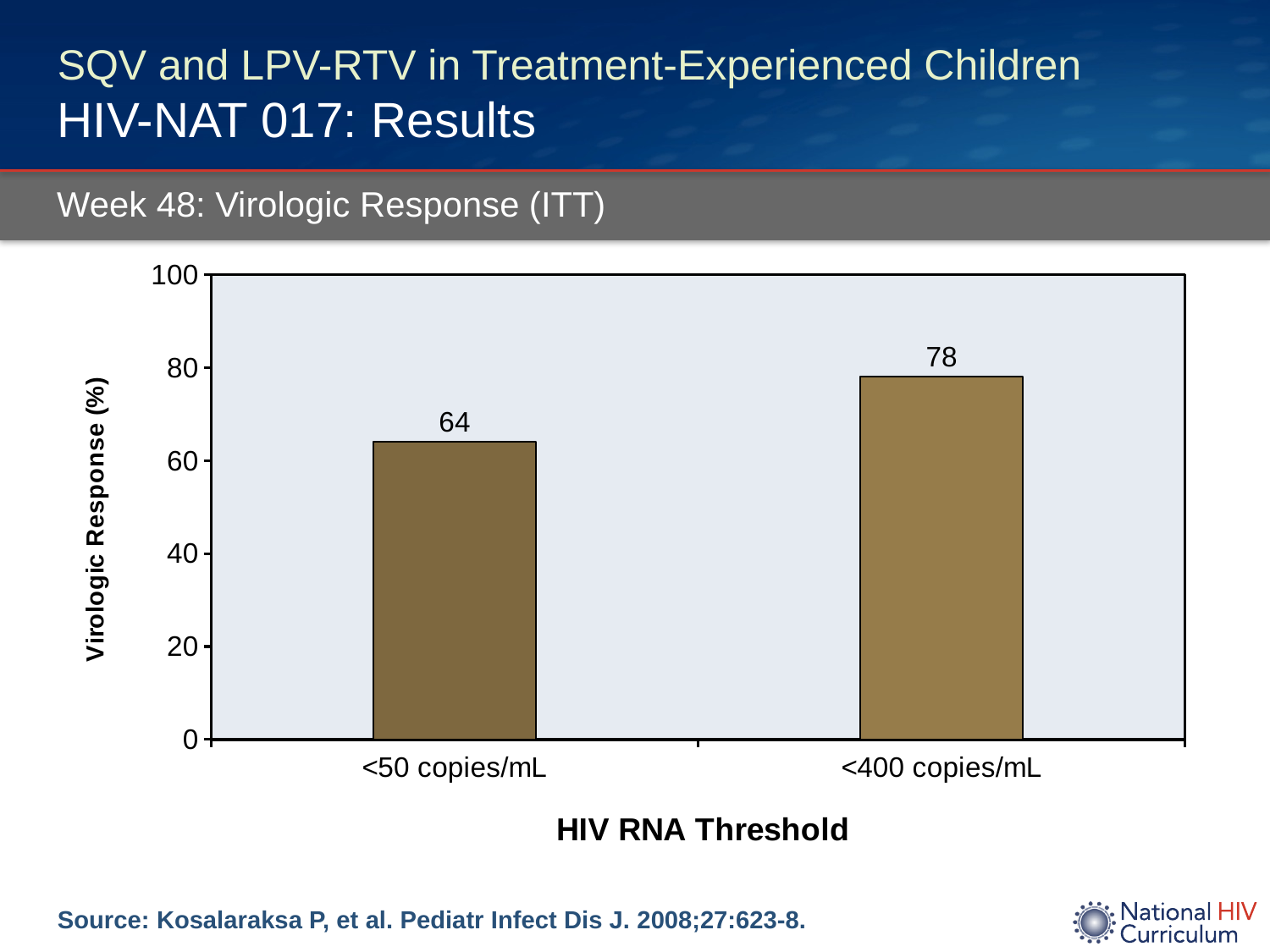
What kind of chart is shown on the slide? Bar chart What is the virologic response for the <400 copies/mL threshold? 78 How many HIV RNA threshold categories are shown in the chart? 2 Which is larger, the virologic response for <50 copies/mL or for <400 copies/mL? <400 copies/mL What is the label of the y-axis? Virologic Response (%) What is the difference in virologic response between the <400 copies/mL and <50 copies/mL thresholds? 14 What is the label of the x-axis? HIV RNA Threshold Which HIV RNA threshold has the lowest virologic response? <50 copies/mL Which HIV RNA threshold has the highest virologic response? <400 copies/mL Is the virologic response for <50 copies/mL greater or less than 60? greater What is the virologic response for the <50 copies/mL threshold? 64 Is the virologic response for <400 copies/mL greater or less than 80? less